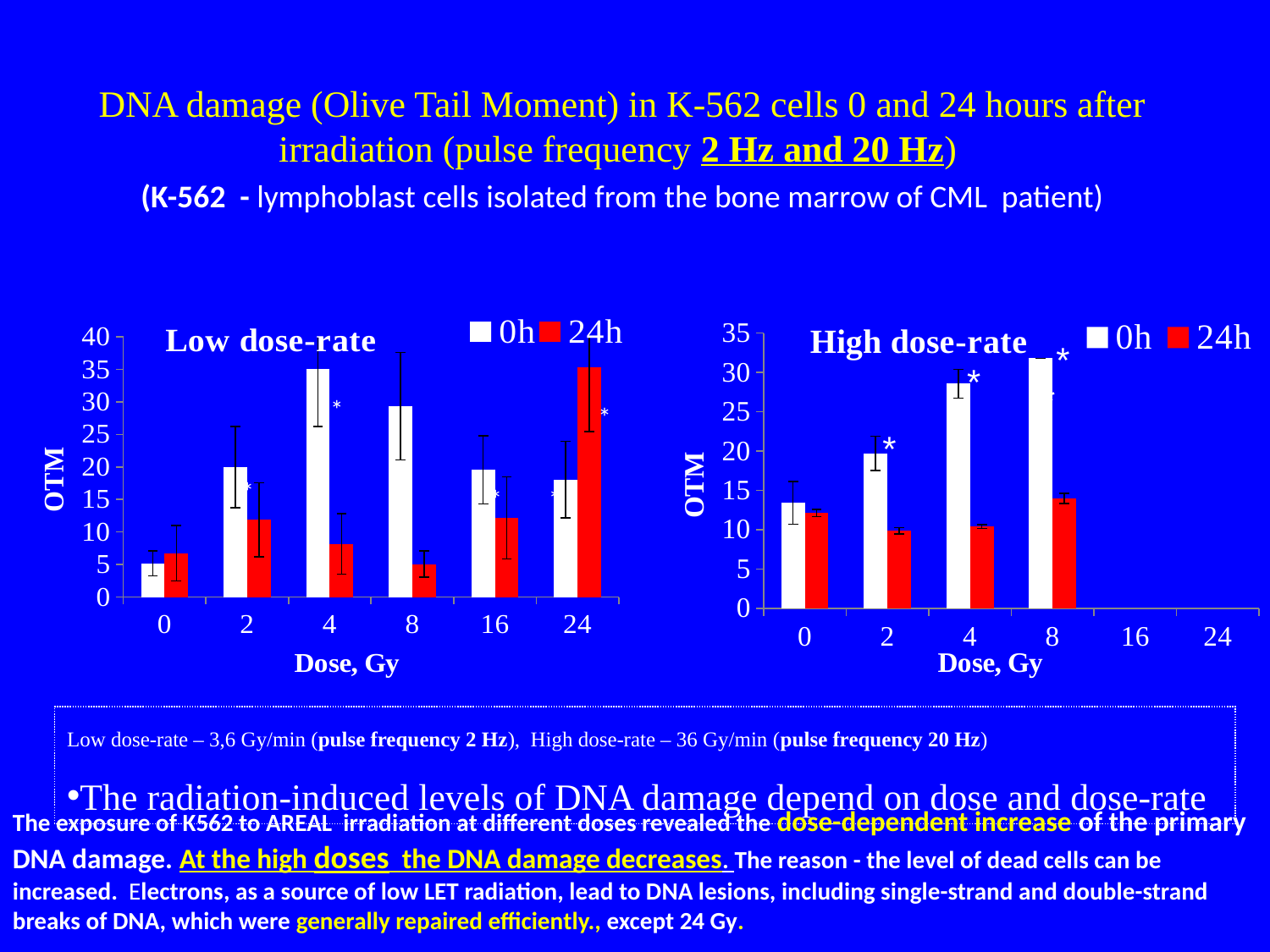
In the Low dose-rate chart, is the 24h value at 8 Gy greater or less than 10? less How many dose categories are shown on the x axis of the Low dose-rate chart? 6 In the High dose-rate chart, at which dose is the 0h value highest? 8 In the High dose-rate chart, is the 0h value at 8 Gy greater or less than 30? greater In the Low dose-rate chart, at which dose is the 24h value highest? 24 In the Low dose-rate chart, at which dose is the 0h value lowest? 0 In the Low dose-rate chart, is the 0h value at 4 Gy greater or less than 30? greater What kind of chart is the Low dose-rate chart? bar chart In the Low dose-rate chart, at which dose is the 0h value highest? 4 How many series does the legend of the High dose-rate chart list? 2 In the High dose-rate chart, at 4 Gy, which is larger: the 0h value or the 24h value? 0h What is the y-axis title of the High dose-rate chart? OTM